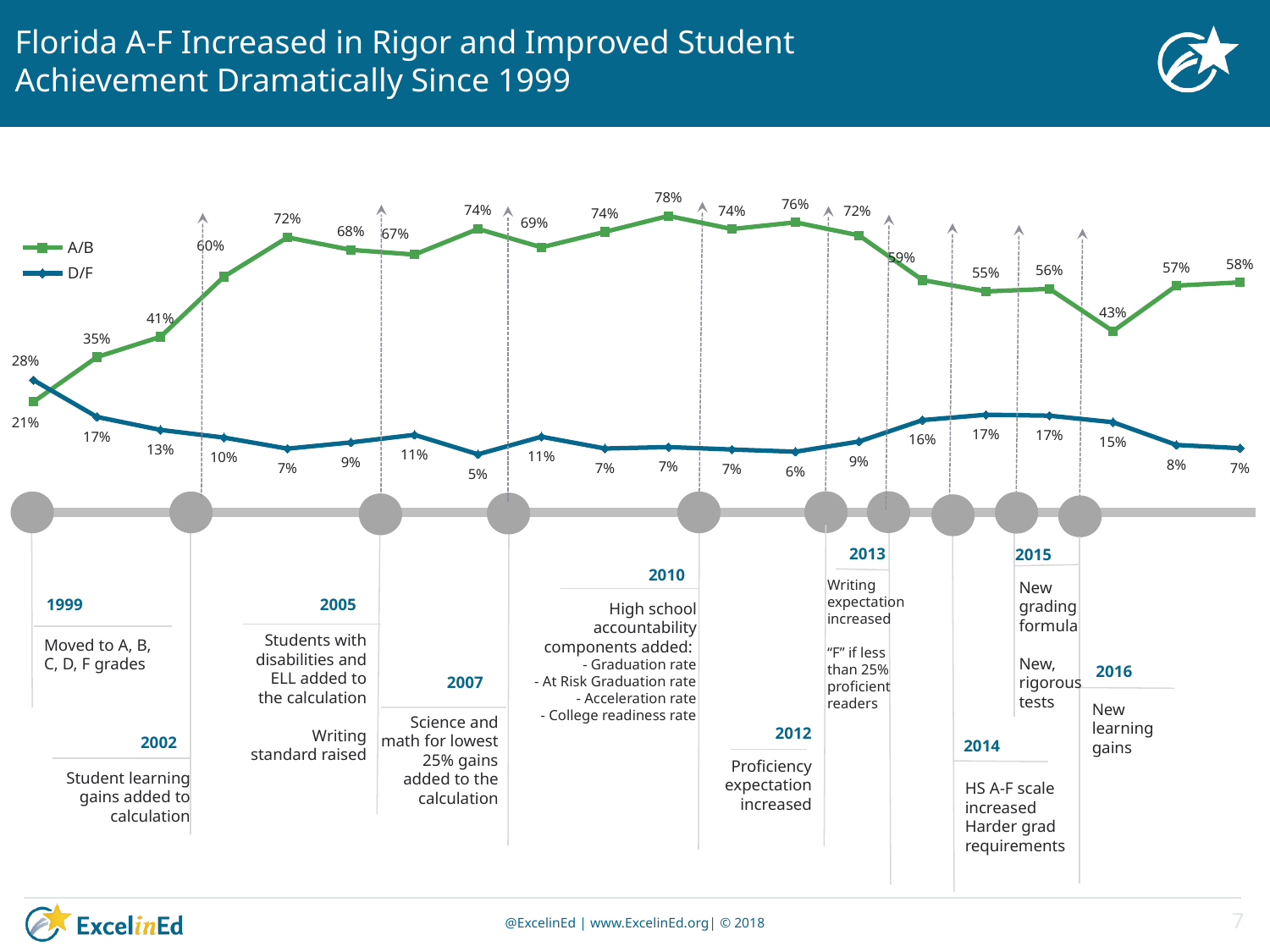
What is the difference between the last A/B value (58%) and the first A/B value (21%)? 37 percentage points What is the highest value shown for the D/F series? 28% What is the first (leftmost) value of the A/B series? 21% How many series does the chart's legend list? 2 What is the highest value shown for the A/B series? 78% What is the lowest value shown for the A/B series? 21% What kind of chart is shown on the slide? Line chart What are the two series named in the chart's legend? A/B and D/F What is the last (rightmost) value of the D/F series? 7% Overall, does the A/B series rise or fall from the left end of the chart to the right end? Rise At the leftmost data point, which series has the higher value, A/B or D/F? D/F What is the lowest value shown for the D/F series? 5%